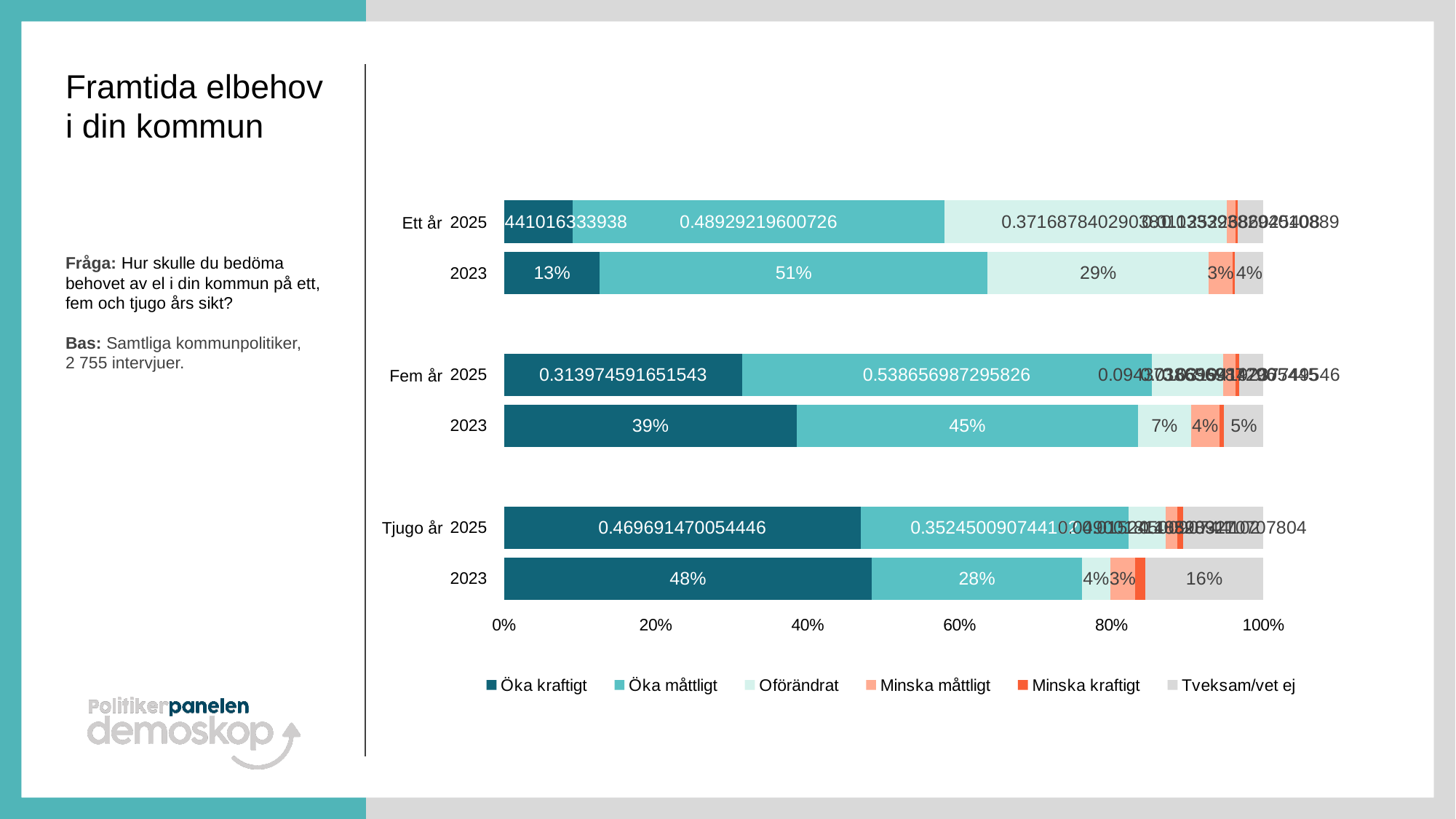
What is the value for Öka måttligt in the Ett år 2023 bar? 51% What kind of chart is shown on the slide? Stacked bar chart What is the value for Öka kraftigt in the Fem år 2023 bar? 39% Is the Öka kraftigt segment of the Ett år 2025 bar greater or less than 20%? less How many bars are plotted in the chart? 6 What is the value for Tveksam/vet ej in the Tjugo år 2023 bar? 16% What is the value for Öka måttligt in the Fem år 2025 bar? 0.538656987295826 Among the 2023 bars, which time horizon has the highest value for Öka kraftigt? Tjugo år In the Tjugo år 2023 bar, which is larger: Öka kraftigt or Öka måttligt? Öka kraftigt What is the value for Oförändrat in the Ett år 2023 bar? 29% In the Fem år 2023 bar, what is the difference between Öka måttligt and Oförändrat? 38 percentage points How many series does the legend list? 6